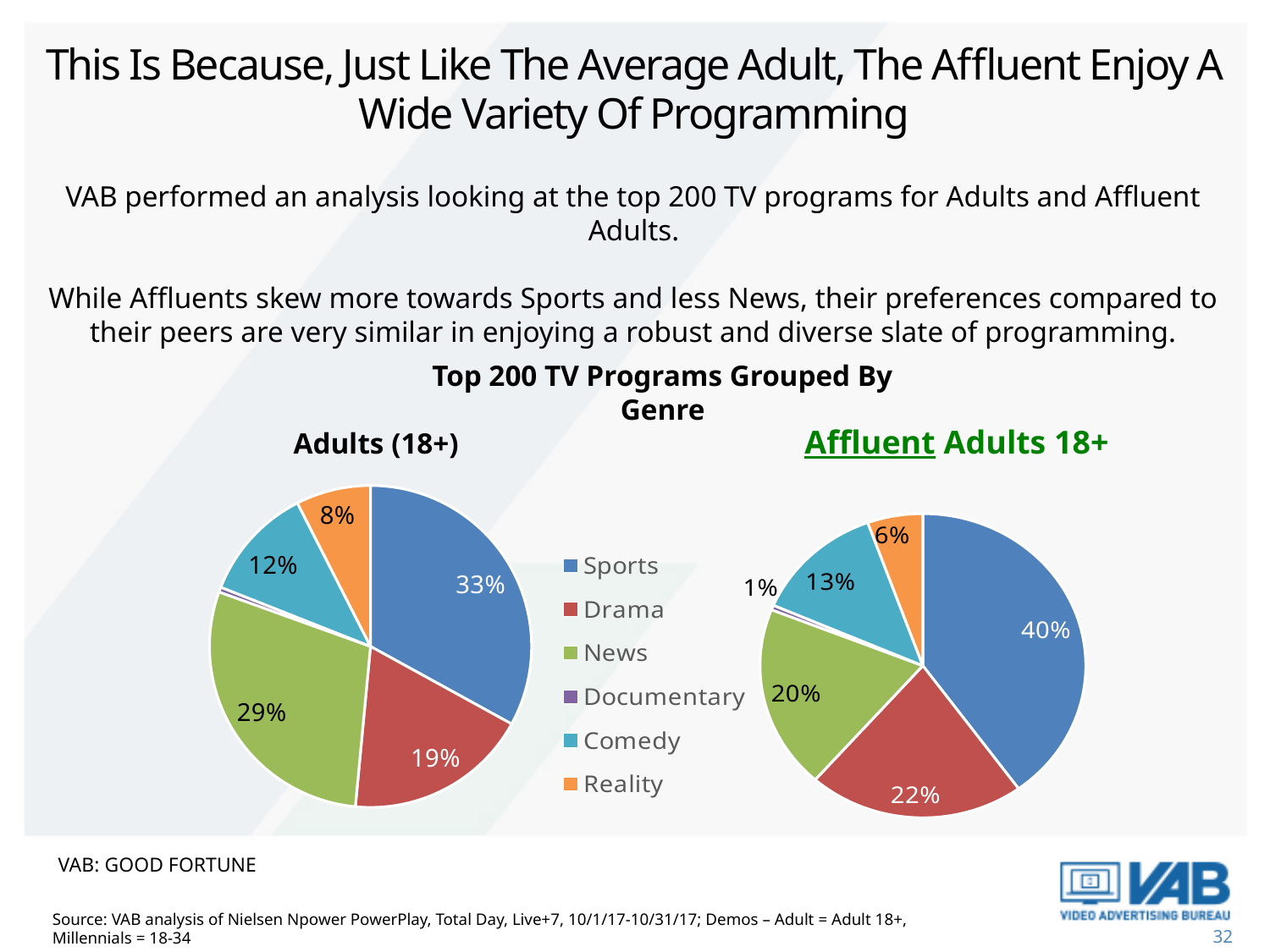
What is the difference between the Sports share in the Affluent Adults 18+ chart and the Sports share in the Adults (18+) chart? 7% In the Adults (18+) chart, what is the value for News? 29% In the Adults (18+) chart, what share of the top 200 TV programs is Sports? 33% In the Adults (18+) chart, what is the difference between the News share and the Drama share? 10% In the Affluent Adults 18+ chart, what is the value for Documentary? 1% How many genres does the legend list? 6 What type of chart is used to show the Top 200 TV Programs Grouped By Genre? Pie chart In the Affluent Adults 18+ chart, which genre has the largest share? Sports In the Affluent Adults 18+ chart, what share of the top 200 TV programs is Sports? 40% In the Affluent Adults 18+ chart, is the share for Drama larger or smaller than the share for Comedy? larger In the Adults (18+) chart, which labelled genre has the smallest share? Reality Which chart shows a larger share for News, Adults (18+) or Affluent Adults 18+? Adults (18+)